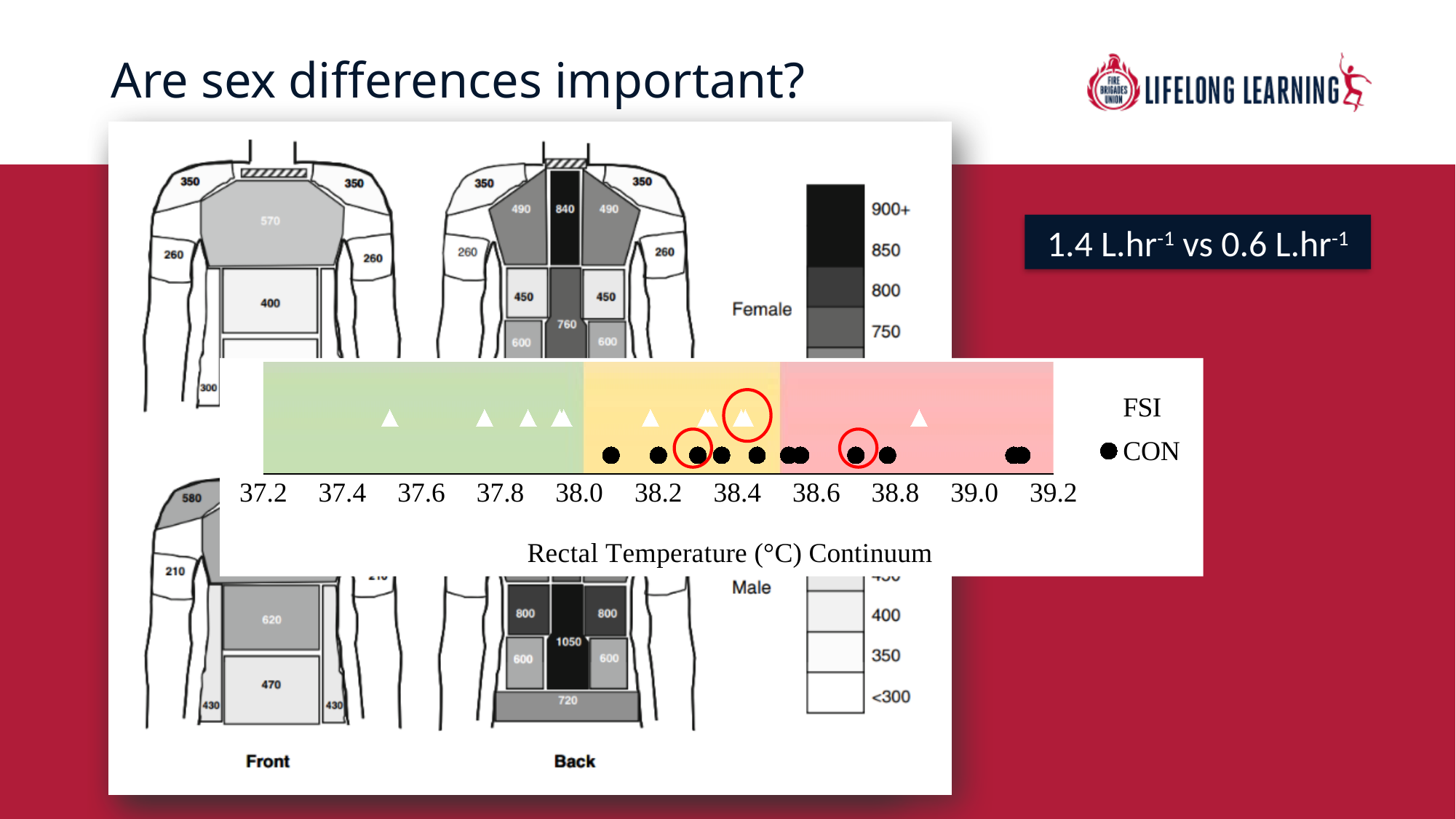
In the rectal temperature chart, which series contains the lowest plotted temperature? FSI In the rectal temperature chart, which series contains the highest plotted temperature? CON In the rectal temperature chart, is the highest CON value greater or less than 39.0? greater In the rectal temperature chart, is the lowest FSI value greater or less than 38.0? less In the rectal temperature chart, is the lowest CON value greater or less than 38.0? greater In the rectal temperature chart, what is the lowest value labelled on the x axis? 37.2 In the rectal temperature chart, which series is plotted with circle markers? CON In the rectal temperature chart, what is the highest value labelled on the x axis? 39.2 In the rectal temperature chart, what is the title of the x axis? Rectal Temperature (°C) Continuum In the rectal temperature chart, how many series does the legend list? 2 In the rectal temperature chart, which series is plotted with triangle markers? FSI